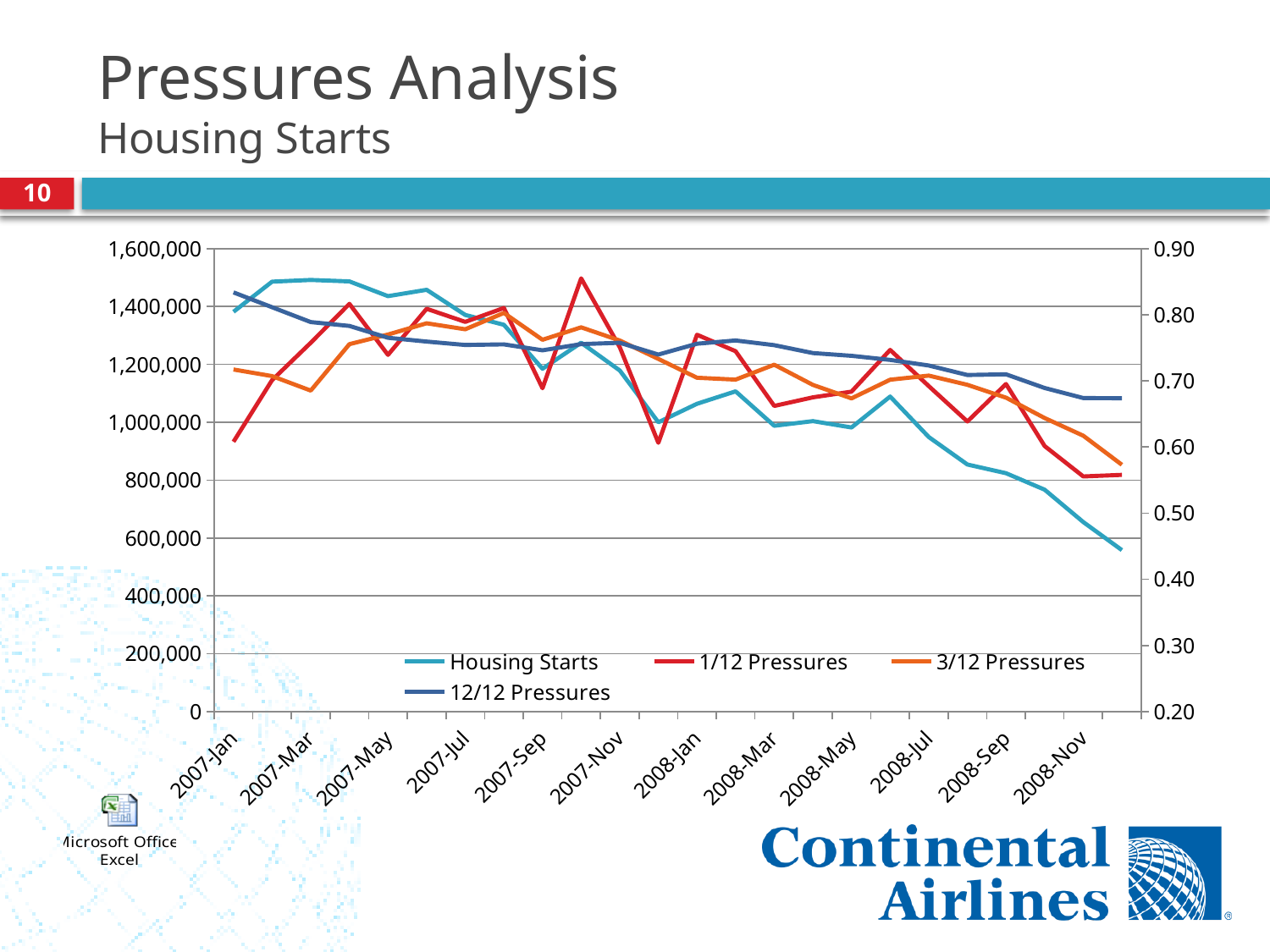
How many series does the legend list? 4 What is the subtitle of the slide below 'Pressures Analysis'? Housing Starts How many month labels are shown along the x axis? 12 Is the 12/12 Pressures value for 2007-Jan greater or less than 0.80 on the right axis? greater Does the Housing Starts series generally rise or fall from 2007-Jan to the end of the chart? Fall At 2007-Jan, which is larger: the 1/12 Pressures value or the 3/12 Pressures value? 3/12 Pressures What kind of chart is shown on the slide? Line chart Is the Housing Starts value for 2008-Nov greater or less than 800,000? less Is the Housing Starts value for 2008-Sep greater or less than 1,000,000? less Which series are listed in the chart legend? Housing Starts, 1/12 Pressures, 3/12 Pressures, 12/12 Pressures